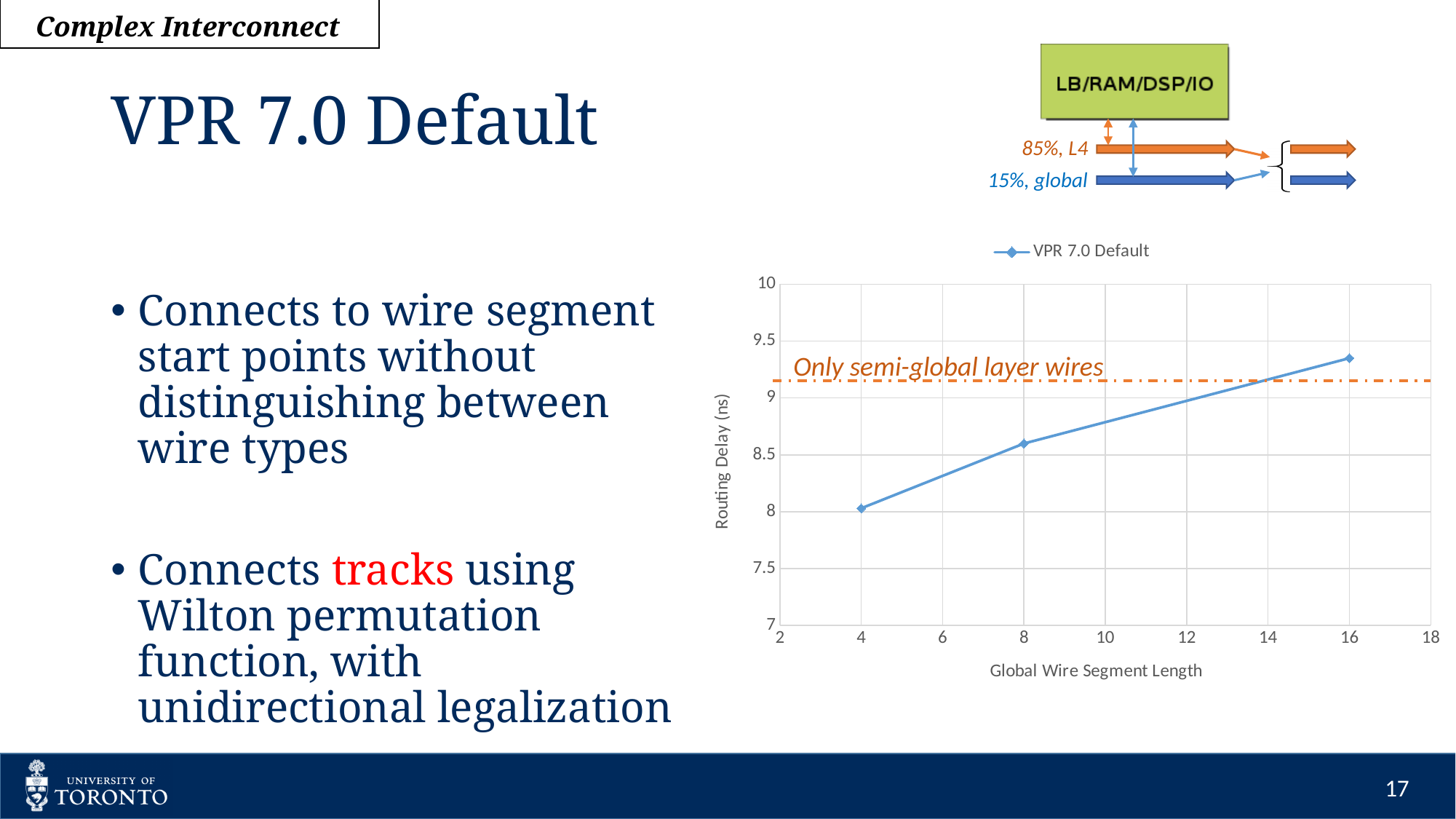
What kind of chart is shown on the slide? line chart What is the label of the chart's y axis? Routing Delay (ns) How many series does the chart legend list? 1 Which has a larger routing delay: a global wire segment length of 8 or 16? 16 At which global wire segment length is the routing delay highest? 16 Is the routing delay at a global wire segment length of 8 greater or less than 9? less Does the routing delay rise or fall as the global wire segment length increases? rises Is the routing delay at a global wire segment length of 16 greater or less than 9? greater At which global wire segment length is the routing delay lowest? 4 How many data points are plotted on the VPR 7.0 Default line? 3 Is the routing delay at a global wire segment length of 4 greater or less than 8.5? less What is the name of the series shown in the chart legend? VPR 7.0 Default